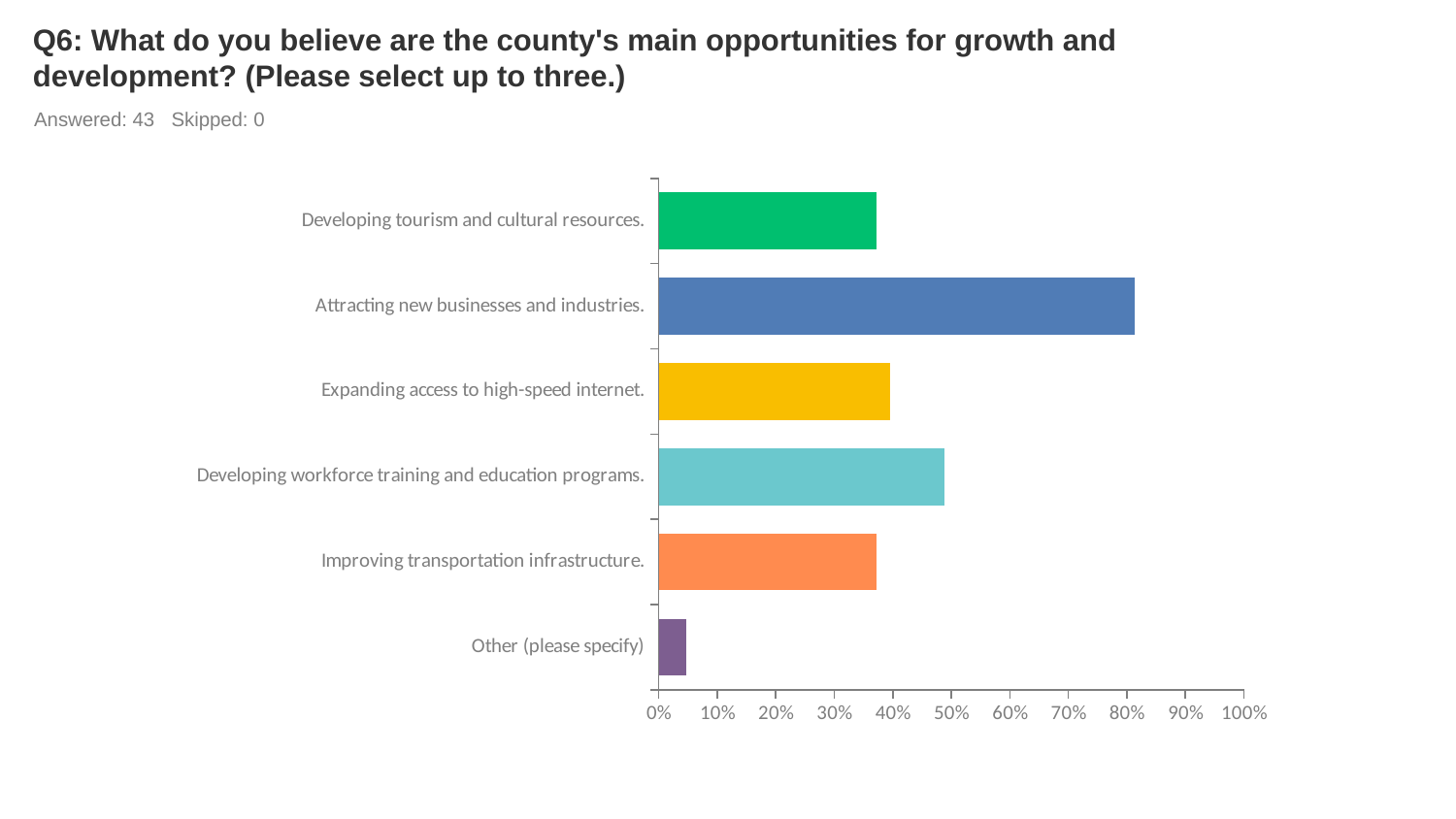
Is the value for Other (please specify) greater or less than 10%? less Is the value for Developing tourism and cultural resources greater or less than 50%? less Which is larger: the value for Developing workforce training and education programs or the value for Expanding access to high-speed internet? Developing workforce training and education programs How many respondents answered the question shown on the slide? 43 What kind of chart is shown on the slide? bar chart How many categories are plotted in the chart? 6 Which category has the highest value? Attracting new businesses and industries. Is the value for Developing workforce training and education programs greater or less than 40%? greater Which is larger: the value for Attracting new businesses and industries or the value for Improving transportation infrastructure? Attracting new businesses and industries Which category has the lowest value? Other (please specify)